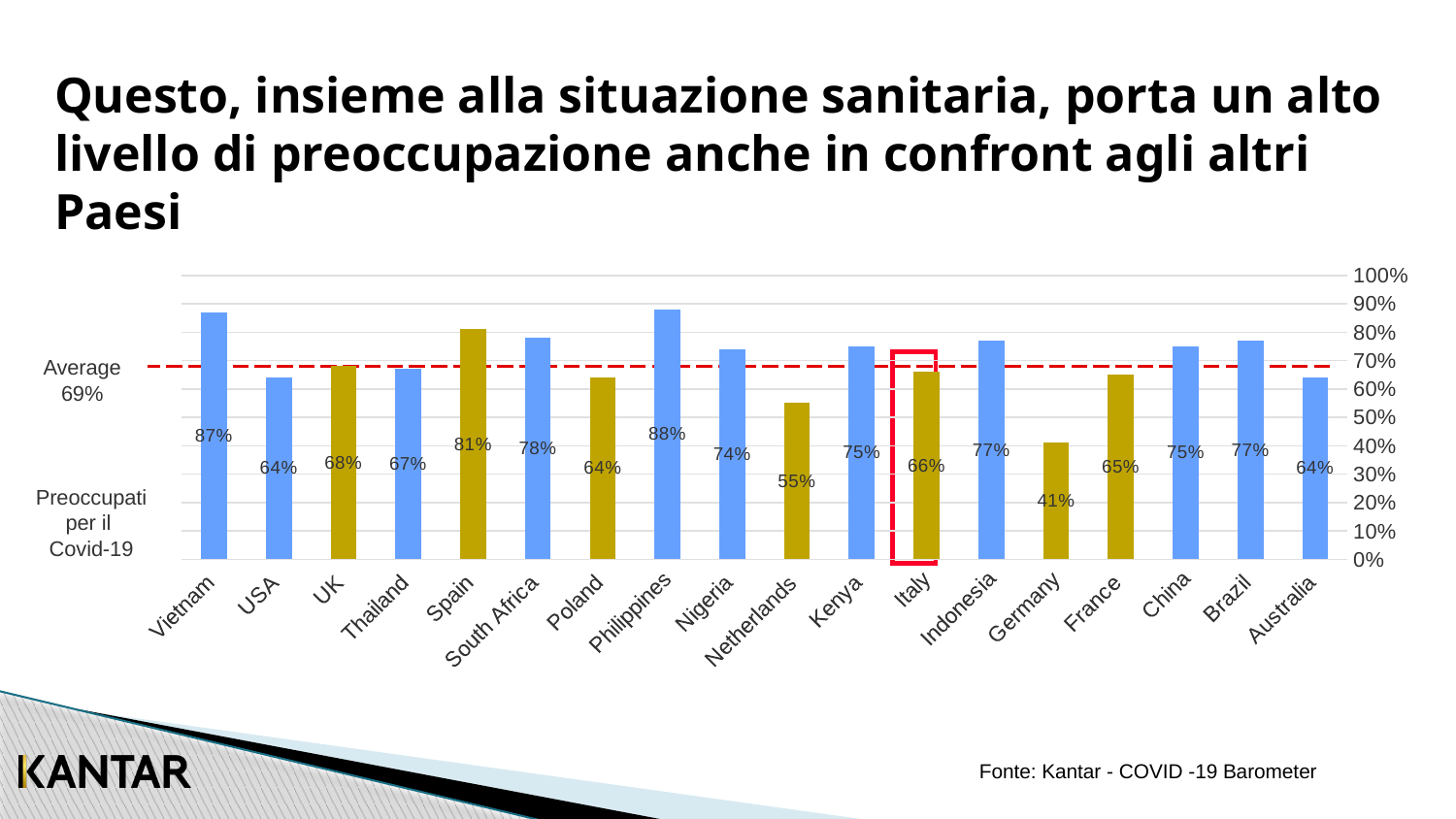
What is the value for Vietnam? 87% What kind of chart is shown on the slide? Bar chart What is the value for Italy? 66% What average value is marked by the dashed red line? 69% Which is larger, the value for Netherlands or the value for Nigeria? Nigeria What is the value for Germany? 41% What is the difference between the values for Philippines and Germany? 47% What is the difference between the values for Spain and Italy? 15% Which country has the lowest value? Germany Which country has the highest value? Philippines Which is larger, the value for Spain or the value for France? Spain How many countries are shown on the chart? 18